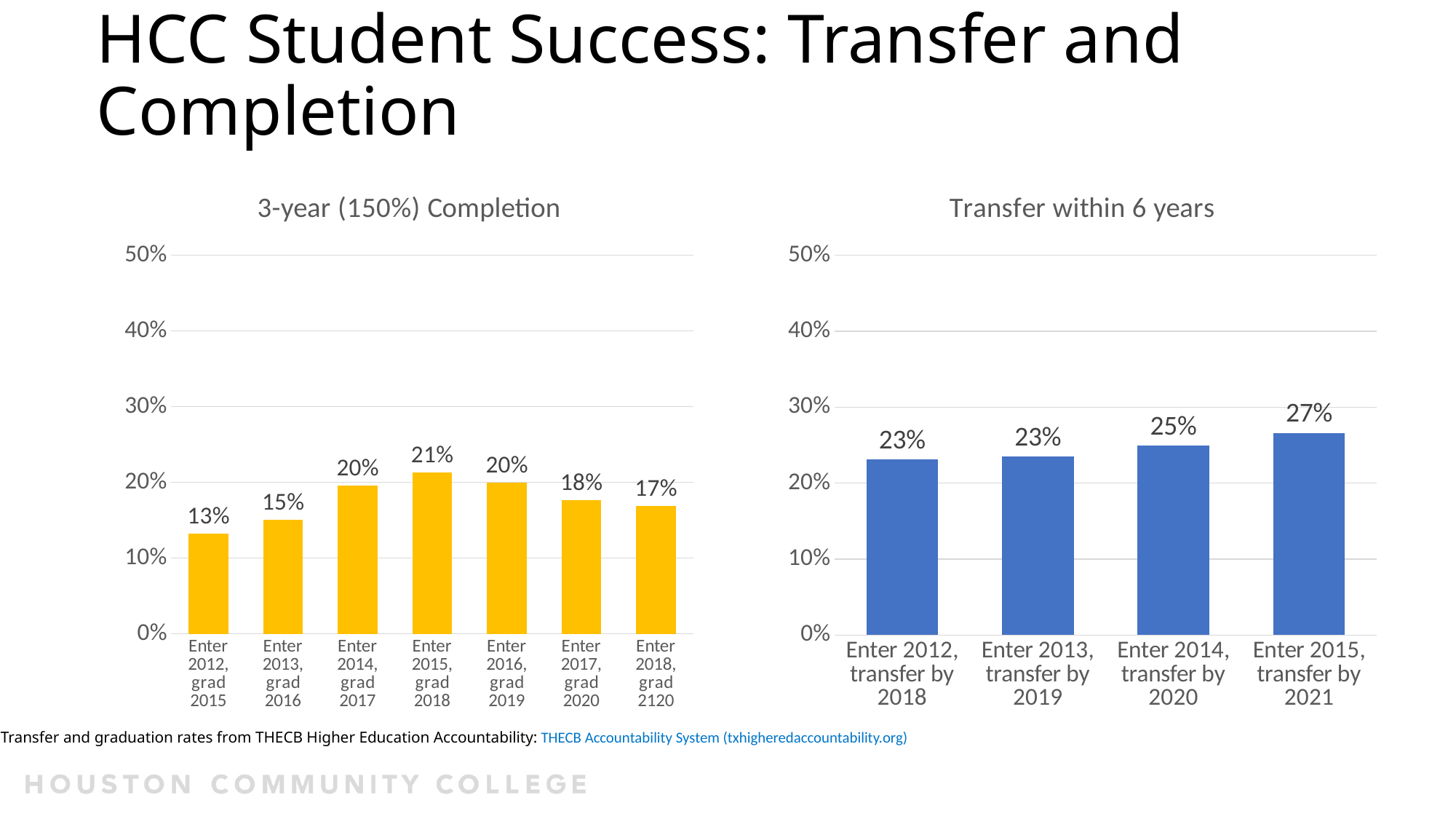
In the '3-year (150%) Completion' chart, what is the value for 'Enter 2017, grad 2020'? 18% In the '3-year (150%) Completion' chart, what is the difference between the values for 'Enter 2015, grad 2018' and 'Enter 2012, grad 2015'? 8% In the 'Transfer within 6 years' chart, is the value for 'Enter 2015, transfer by 2021' greater or less than 30%? less In the 'Transfer within 6 years' chart, what is the difference between the values for 'Enter 2015, transfer by 2021' and 'Enter 2012, transfer by 2018'? 4% In the '3-year (150%) Completion' chart, which category has the highest value? Enter 2015, grad 2018 In the 'Transfer within 6 years' chart, which category has the highest value? Enter 2015, transfer by 2021 What kind of chart is the 'Transfer within 6 years' chart? bar chart In the 'Transfer within 6 years' chart, do the values rise or fall from left to right along the x axis? rise In the 'Transfer within 6 years' chart, what is the value for 'Enter 2014, transfer by 2020'? 25% In the '3-year (150%) Completion' chart, what is the value for 'Enter 2012, grad 2015'? 13% In the '3-year (150%) Completion' chart, which category has the lowest value? Enter 2012, grad 2015 In the '3-year (150%) Completion' chart, how many bars are plotted? 7